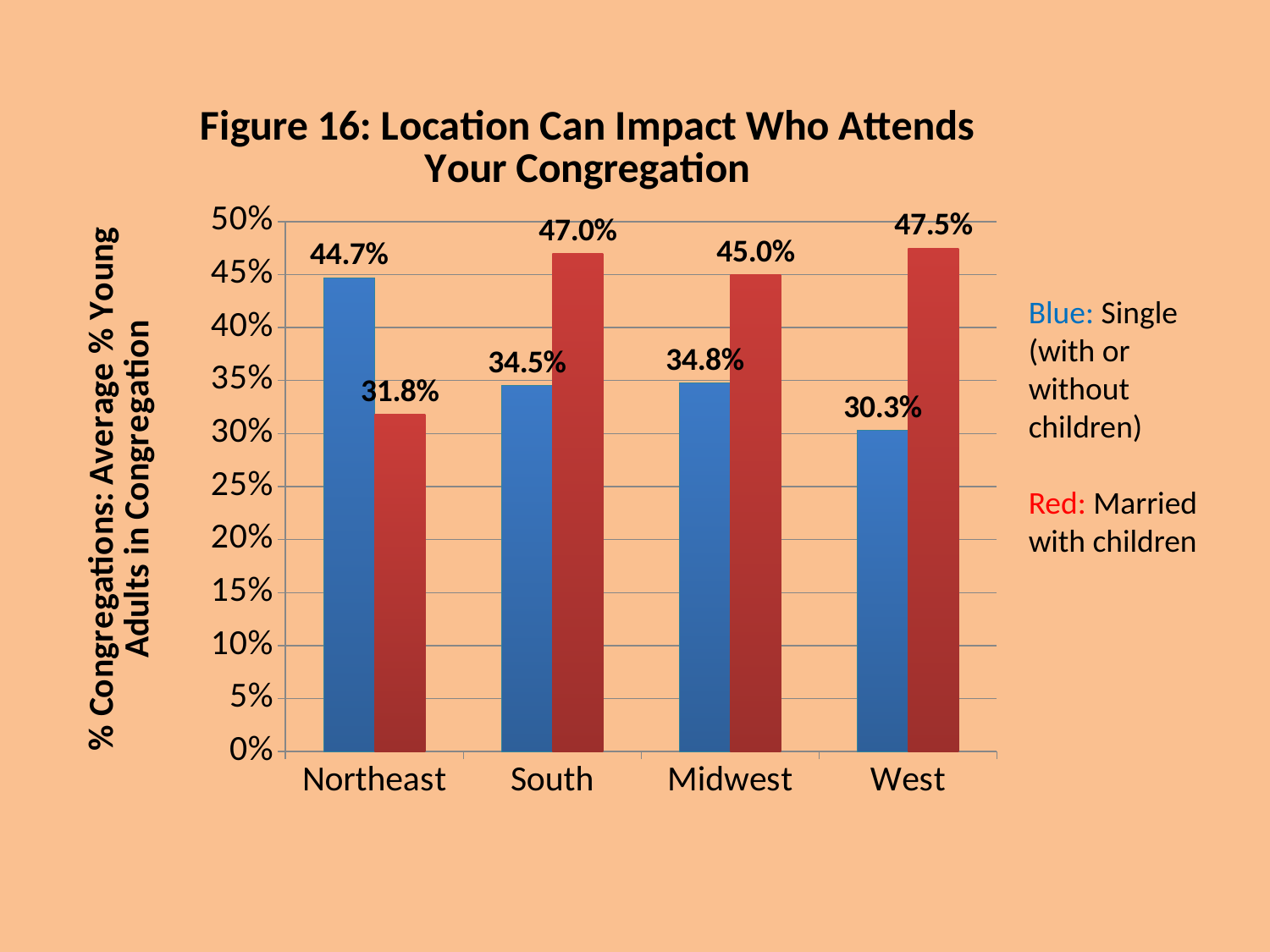
What is the difference between the Married with children (red) and Single (blue) values in the Northeast? 12.9% What type of chart is shown on the slide? Bar chart What is the value for Married with children (red) in the West? 47.5% In the Midwest, which is larger: the Single (blue) value or the Married with children (red) value? Married with children (red) How many data series does the chart show? 2 What is the title of the chart? Figure 16: Location Can Impact Who Attends Your Congregation Which region has the highest value for Married with children (red)? West What is the value for Single (blue) in the Northeast? 44.7% What is the value for Single (blue) in the Midwest? 34.8% What is the value for Married with children (red) in the South? 47.0% How many regions are shown on the x axis? 4 Which region has the lowest value for Single (blue)? West